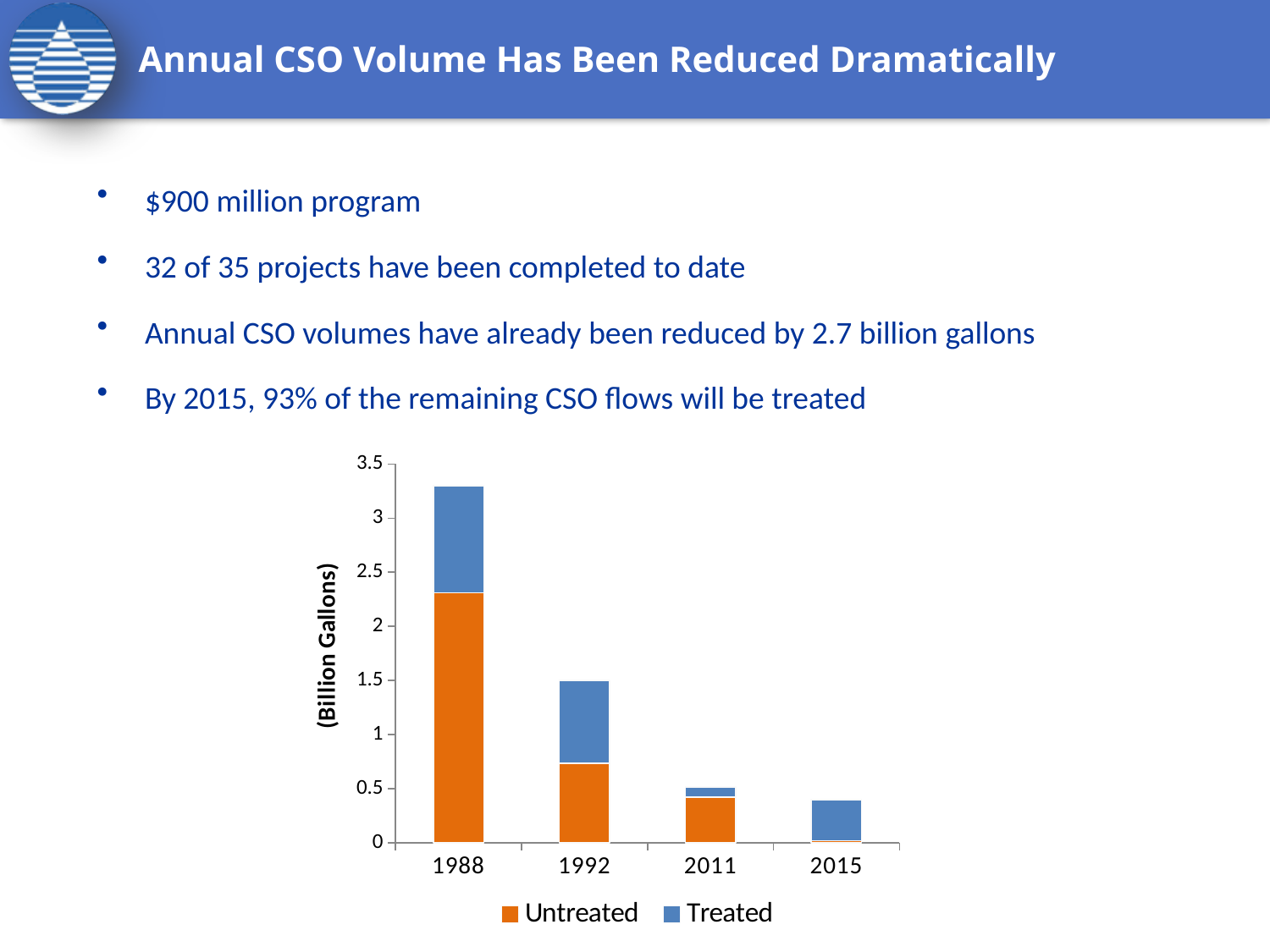
Is the Untreated value for 1988 greater or less than 2? greater Which year has the tallest stacked bar in the chart? 1988 Is the total stacked bar for 2011 greater or less than 1? less Which year has the smallest Untreated segment in the chart? 2015 What kind of chart is shown on the slide? stacked bar chart How many series does the chart legend list? 2 Is the total stacked bar for 1988 greater or less than 3? greater What is the label on the vertical axis of the chart? (Billion Gallons) Which is larger in 1988, the Untreated segment or the Treated segment? Untreated How many years are shown on the x axis of the chart? 4 Do the total CSO volumes rise or fall from 1988 to 2015 in the chart? fall